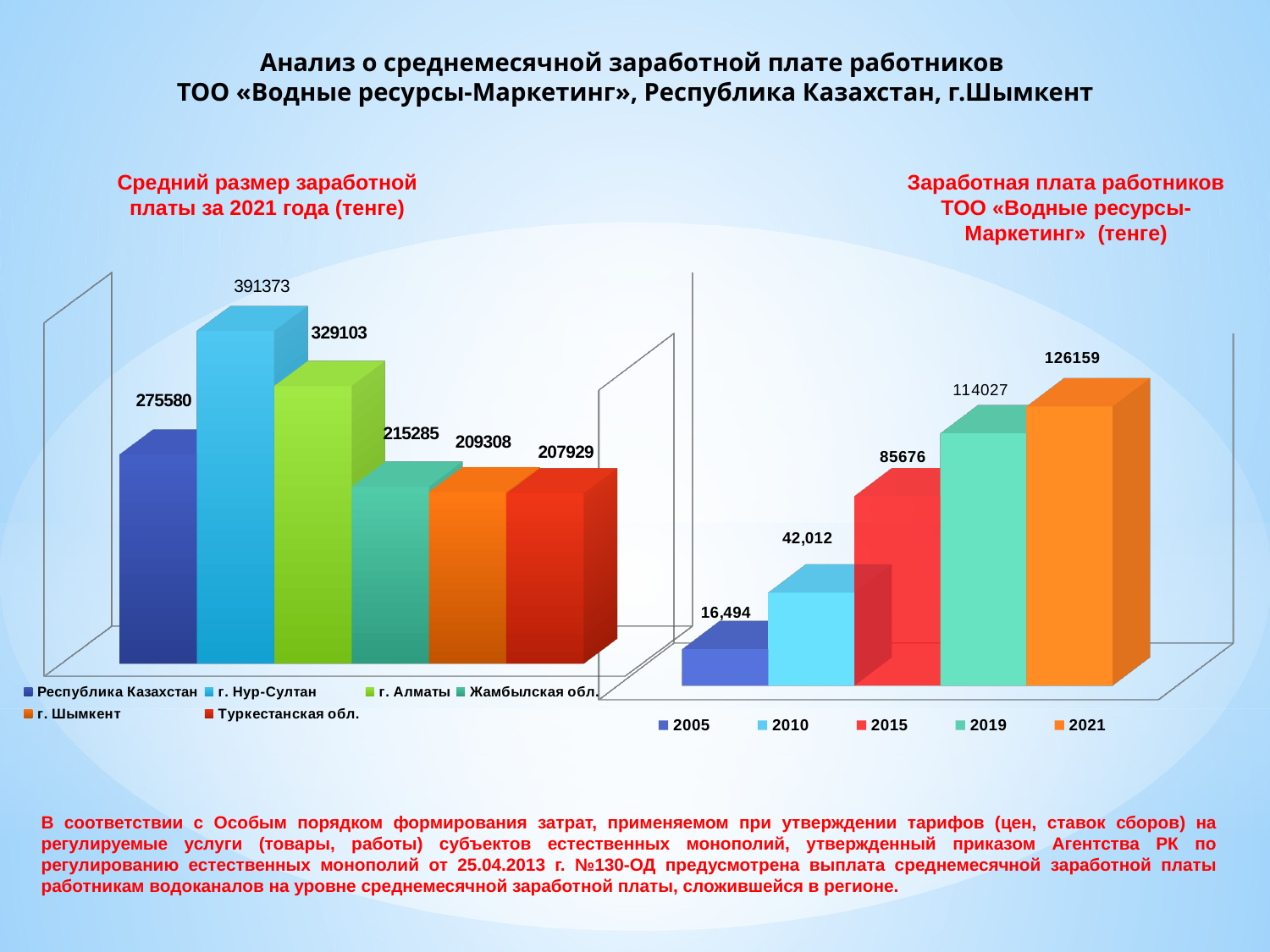
In the left chart (Средний размер заработной платы за 2021 года), what is the value for Республика Казахстан? 275580 In the left chart (Средний размер заработной платы за 2021 года), what is the difference between the values for г. Нур-Султан and г. Алматы? 62270 In the right chart (Заработная плата работников ТОО «Водные ресурсы-Маркетинг»), what is the value for 2021? 126159 In the right chart (Заработная плата работников ТОО «Водные ресурсы-Маркетинг»), do the values rise or fall from 2005 to 2021? rise In the right chart (Заработная плата работников ТОО «Водные ресурсы-Маркетинг»), which year has the lowest value? 2005 In the left chart (Средний размер заработной платы за 2021 года), how many categories does the legend list? 6 In the right chart (Заработная плата работников ТОО «Водные ресурсы-Маркетинг»), what is the value for 2010? 42,012 In the left chart (Средний размер заработной платы за 2021 года), which category has the lowest value? Туркестанская обл. In the left chart (Средний размер заработной платы за 2021 года), what is the value for г. Нур-Султан? 391373 What kind of chart is the right chart (Заработная плата работников ТОО «Водные ресурсы-Маркетинг»)? bar chart In the left chart (Средний размер заработной платы за 2021 года), which category has the highest value? г. Нур-Султан In the right chart (Заработная плата работников ТОО «Водные ресурсы-Маркетинг»), what is the difference between the values for 2021 and 2019? 12132